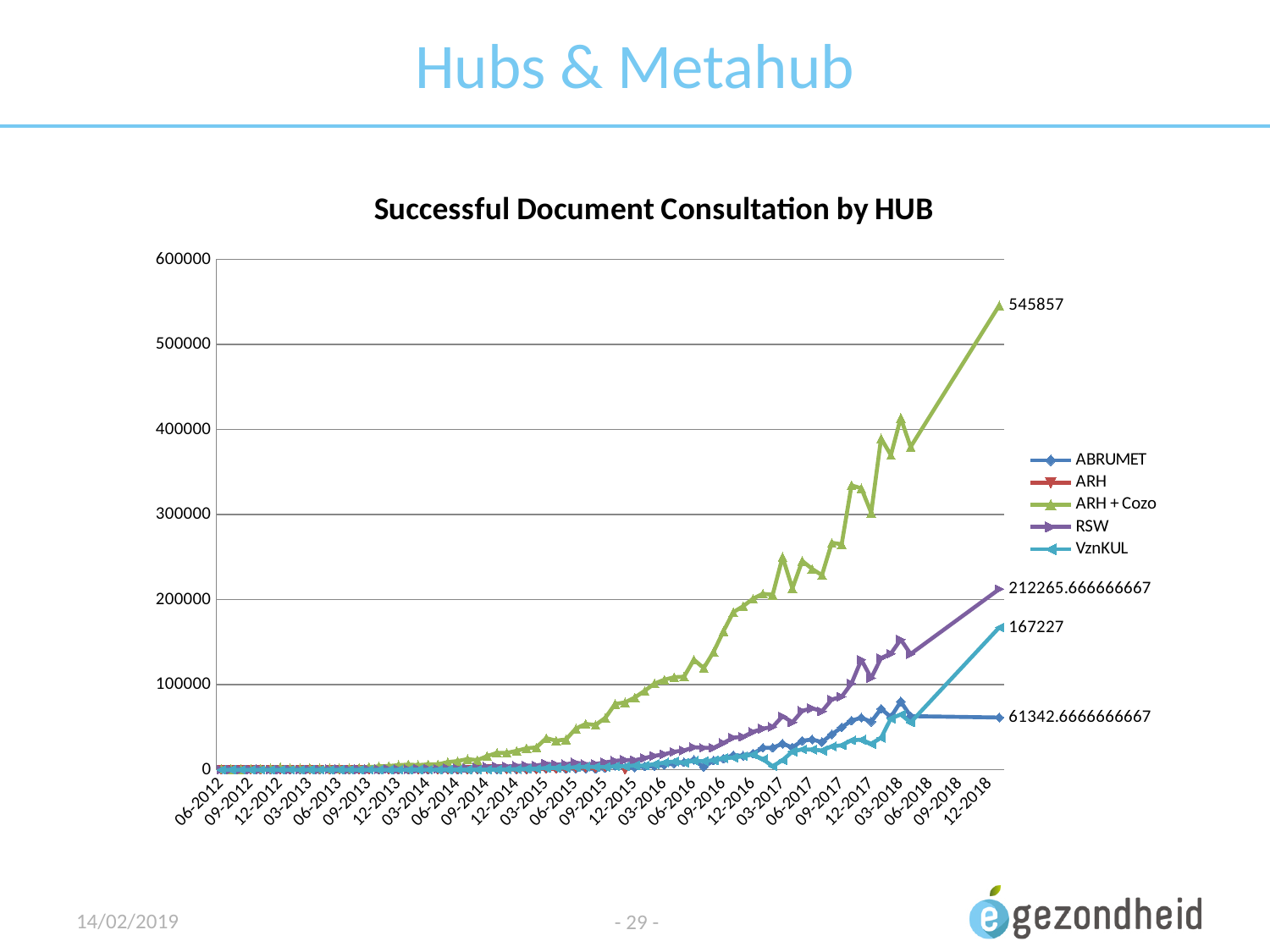
What is the final labelled value for the VznKUL series? 167227 Which series has the highest value at the end of the chart (12-2018)? ARH + Cozo Does the ARH + Cozo series generally rise or fall from 06-2012 to 12-2018? rise What is the final labelled value for the ARH + Cozo series? 545857 What is the final labelled value for the RSW series? 212265.666666667 What is the title of the chart? Successful Document Consultation by HUB What is the difference between the final labelled values of ARH + Cozo and VznKUL? 378630 How many series does the chart legend list? 5 What is the final labelled value for the ABRUMET series? 61342.6666666667 Is the final value for ARH + Cozo greater or less than 500000? greater Which is larger at the end of the chart: the RSW value or the VznKUL value? RSW What kind of chart is shown on the slide? line chart